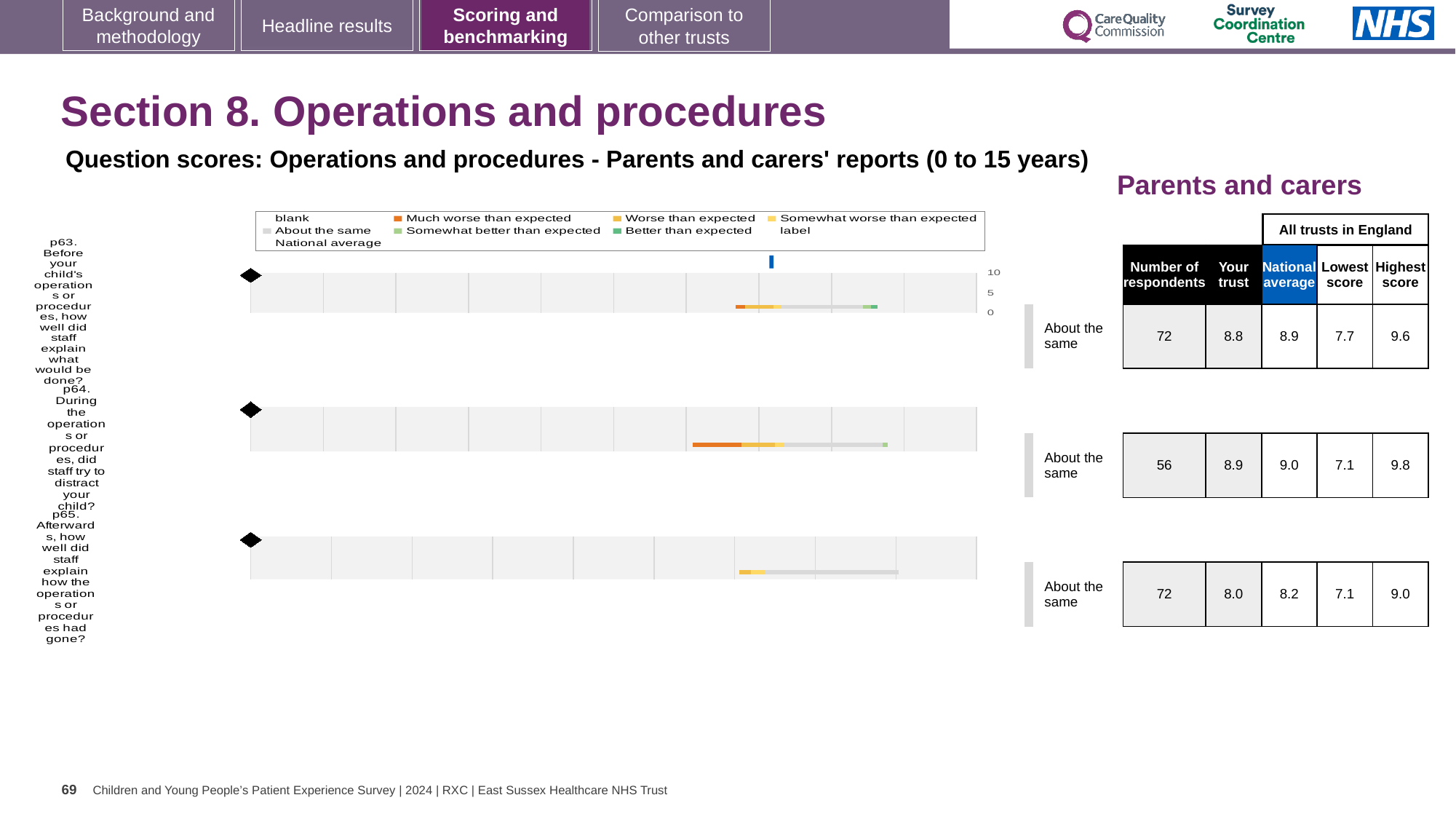
Which question has the highest 'Your trust' score? p64 For p63, which is larger: the 'Your trust' score or the national average? National average How many entries does the chart legend list? 9 How many questions (p63, p64, p65) have a benchmarking bar chart on the slide? 3 For p63 (Before your child's operations or procedures, how well did staff explain what would be done?), what is the 'Your trust' score? 8.8 For p65, what is the difference between the highest score (9.0) and the lowest score (7.1) across all trusts in England? 1.9 What colour does the legend use for 'Much worse than expected'? orange What kind of chart is used to show the question scores for p63, p64 and p65? bar chart For p64 (During the operations or procedures, did staff try to distract your child?), what is the national average score? 9.0 How many respondents are recorded for p64? 56 What is the highest tick value shown on the chart axis for p63? 10 Which question has the lowest 'Your trust' score? p65